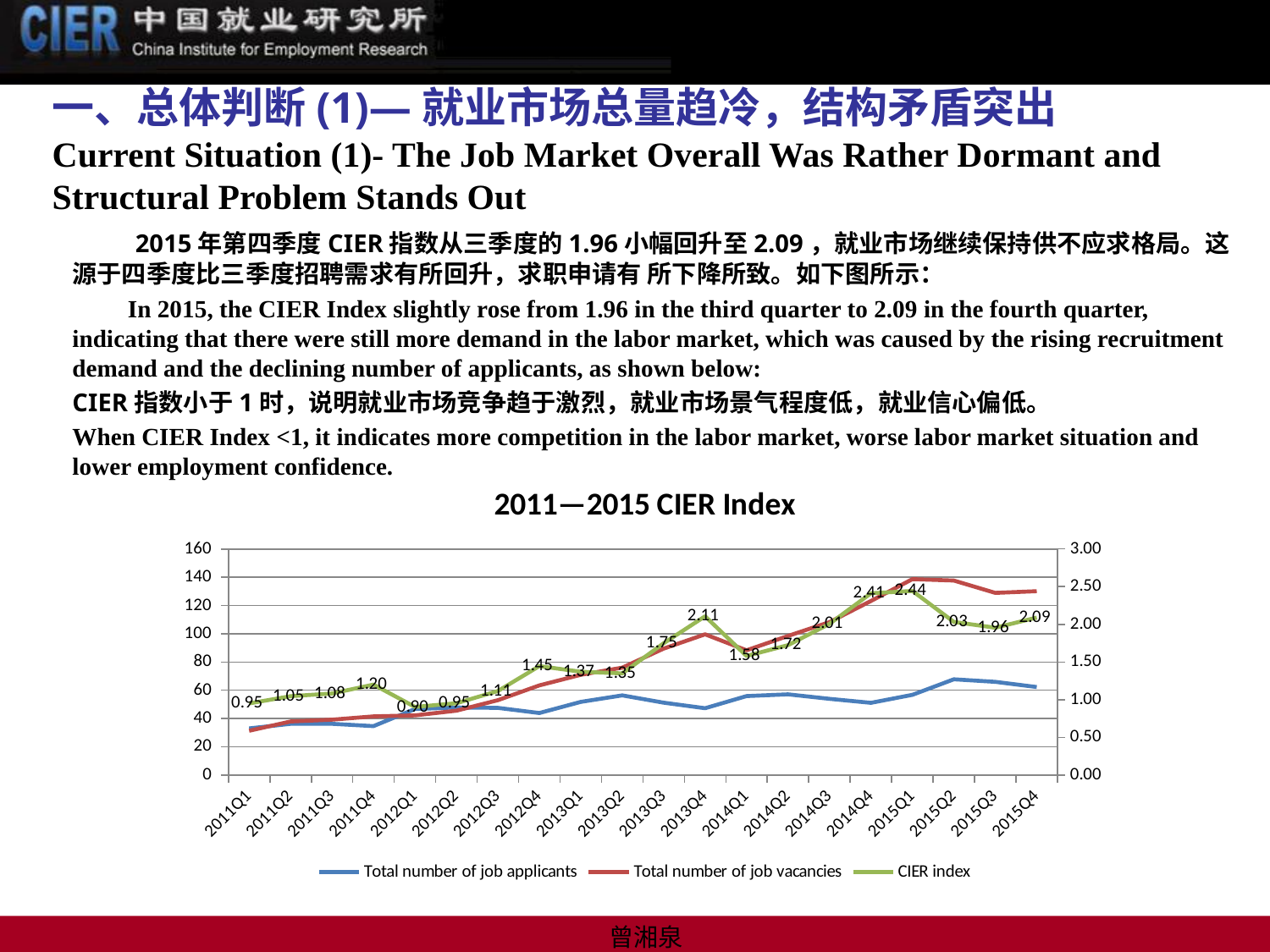
Is the total number of job applicants in 2011Q1 greater or less than 40? less By how much did the CIER index change from 2015Q3 to 2015Q4? 0.13 Which is larger, the CIER index in 2013Q4 or in 2014Q1? 2013Q4 What is the CIER index value for 2012Q4? 1.45 What is the CIER index value for 2015Q4? 2.09 What kind of chart is shown on the slide? Line chart In which quarter is the CIER index at its lowest value? 2012Q1 In which quarter does the CIER index reach its highest value? 2015Q1 Is the total number of job vacancies in 2015Q1 greater or less than 120? greater What is the CIER index value for 2013Q4? 2.11 How many series does the legend list? 3 What is the difference between the CIER index in 2015Q1 and in 2012Q1? 1.54